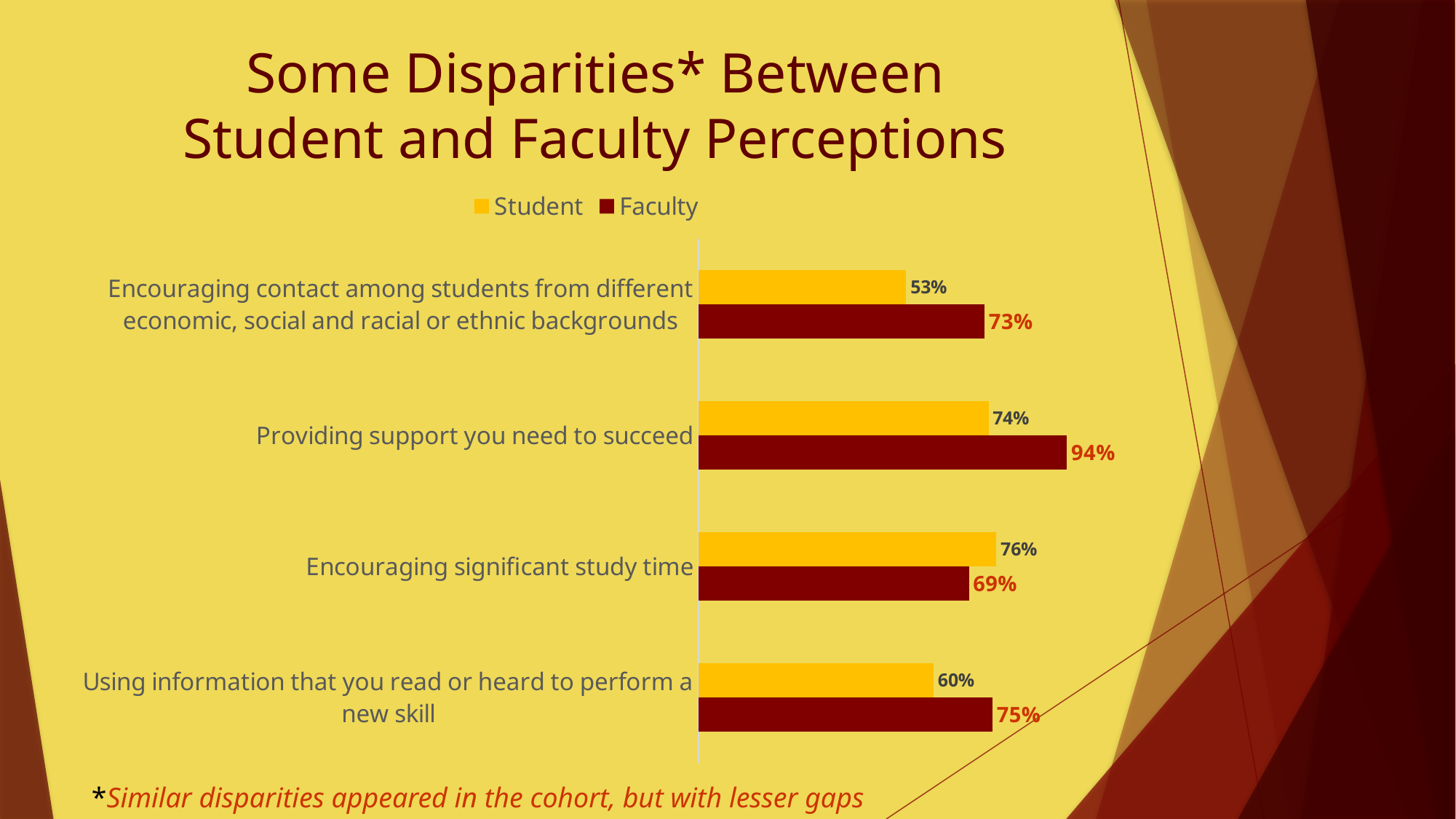
What is the difference between the Faculty and Student values for "Encouraging contact among students from different economic, social and racial or ethnic backgrounds"? 20% What is the Faculty value for "Using information that you read or heard to perform a new skill"? 75% What is the difference between the Faculty and Student values for "Providing support you need to succeed"? 20% What is the Student value for "Providing support you need to succeed"? 74% Which category has the highest Faculty value? Providing support you need to succeed How many categories are shown in the chart? 4 Which colour represents the Faculty series in the chart? Dark red For "Encouraging significant study time", which is larger, the Student value or the Faculty value? Student What is the Faculty value for "Encouraging significant study time"? 69% What kind of chart is shown on the slide? Bar chart Which category has the lowest Student value? Encouraging contact among students from different economic, social and racial or ethnic backgrounds How many series does the legend list? 2